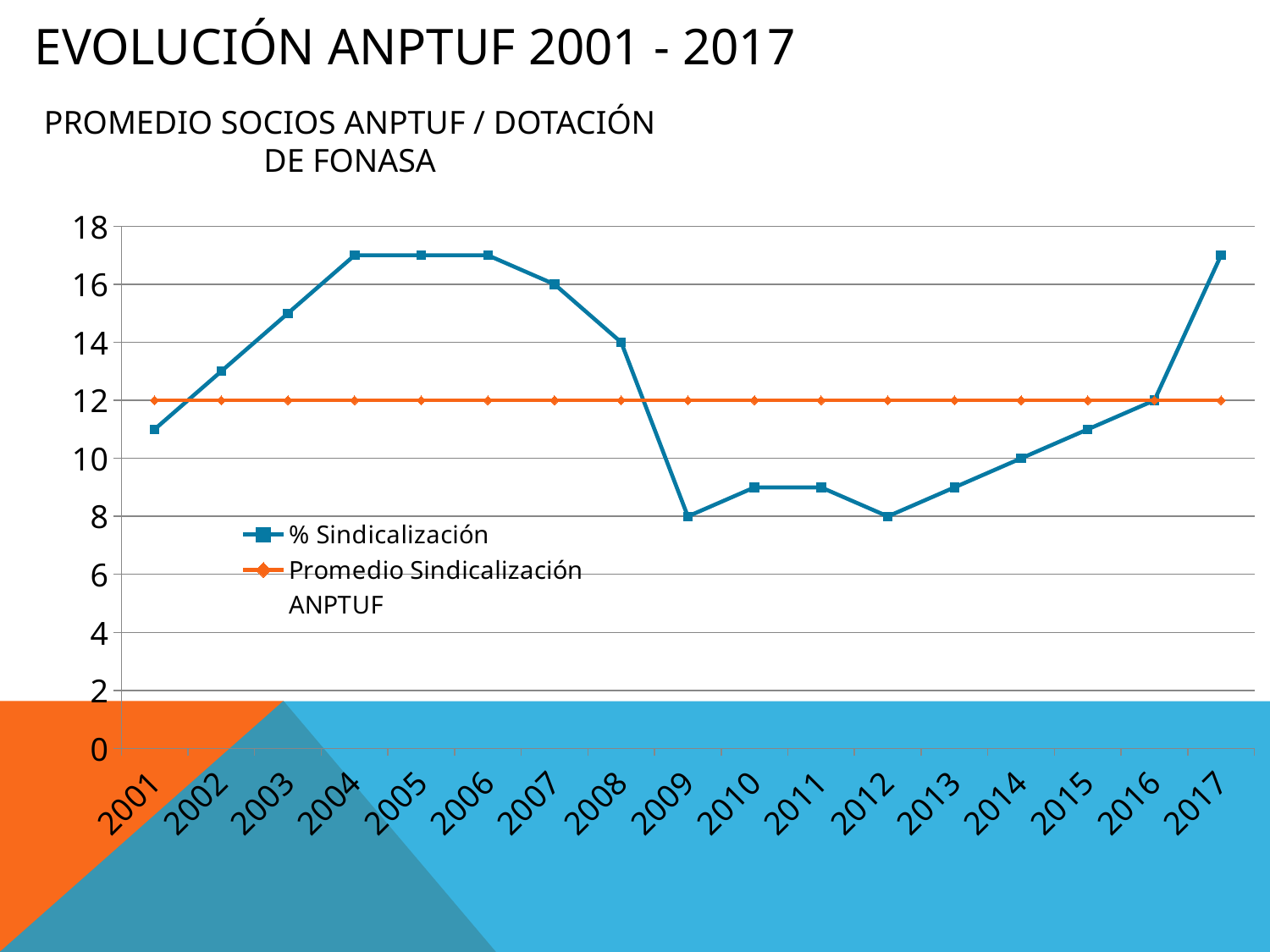
How many series does the legend list? 2 What constant value does the Promedio Sindicalización ANPTUF line show? 12 Is the value for % Sindicalización in 2001 greater or less than 12? less Is the value for % Sindicalización in 2004 greater or less than 16? greater What is the value of % Sindicalización in 2009? 8 What kind of chart is shown on the slide? line chart Does the % Sindicalización line rise or fall from 2012 to 2017? rise How many years are plotted along the x axis? 17 What is the value of % Sindicalización in 2016? 12 Which year has the larger % Sindicalización value, 2003 or 2010? 2003 What is the value of % Sindicalización in 2014? 10 What is the title shown above the chart? PROMEDIO SOCIOS ANPTUF / DOTACIÓN DE FONASA